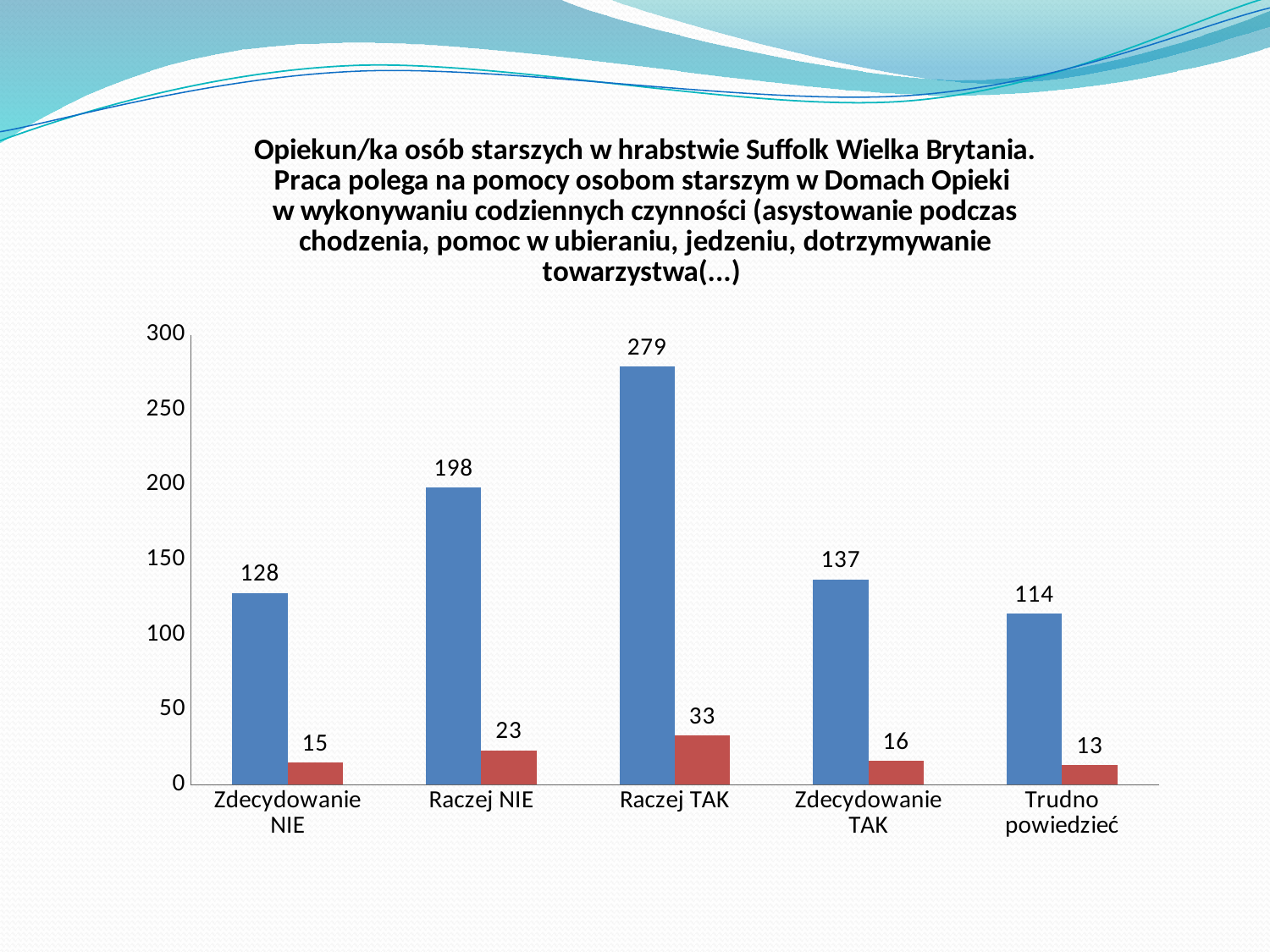
Which category has the highest blue bar? Raczej TAK What is the value of the red bar for Zdecydowanie TAK? 16 Which is larger, the blue bar for Zdecydowanie NIE or the blue bar for Zdecydowanie TAK? Zdecydowanie TAK Which category has the lowest red bar? Trudno powiedzieć What is the value of the red bar for Raczej NIE? 23 What is the value of the blue bar for Raczej TAK? 279 What is the value of the blue bar for Trudno powiedzieć? 114 What is the difference between the blue and red bars for Zdecydowanie NIE? 113 How many categories are shown on the x axis? 5 What is the difference between the blue bars for Raczej TAK and Raczej NIE? 81 What kind of chart is shown on the slide? bar chart Is the blue bar for Raczej NIE greater or less than 150? greater